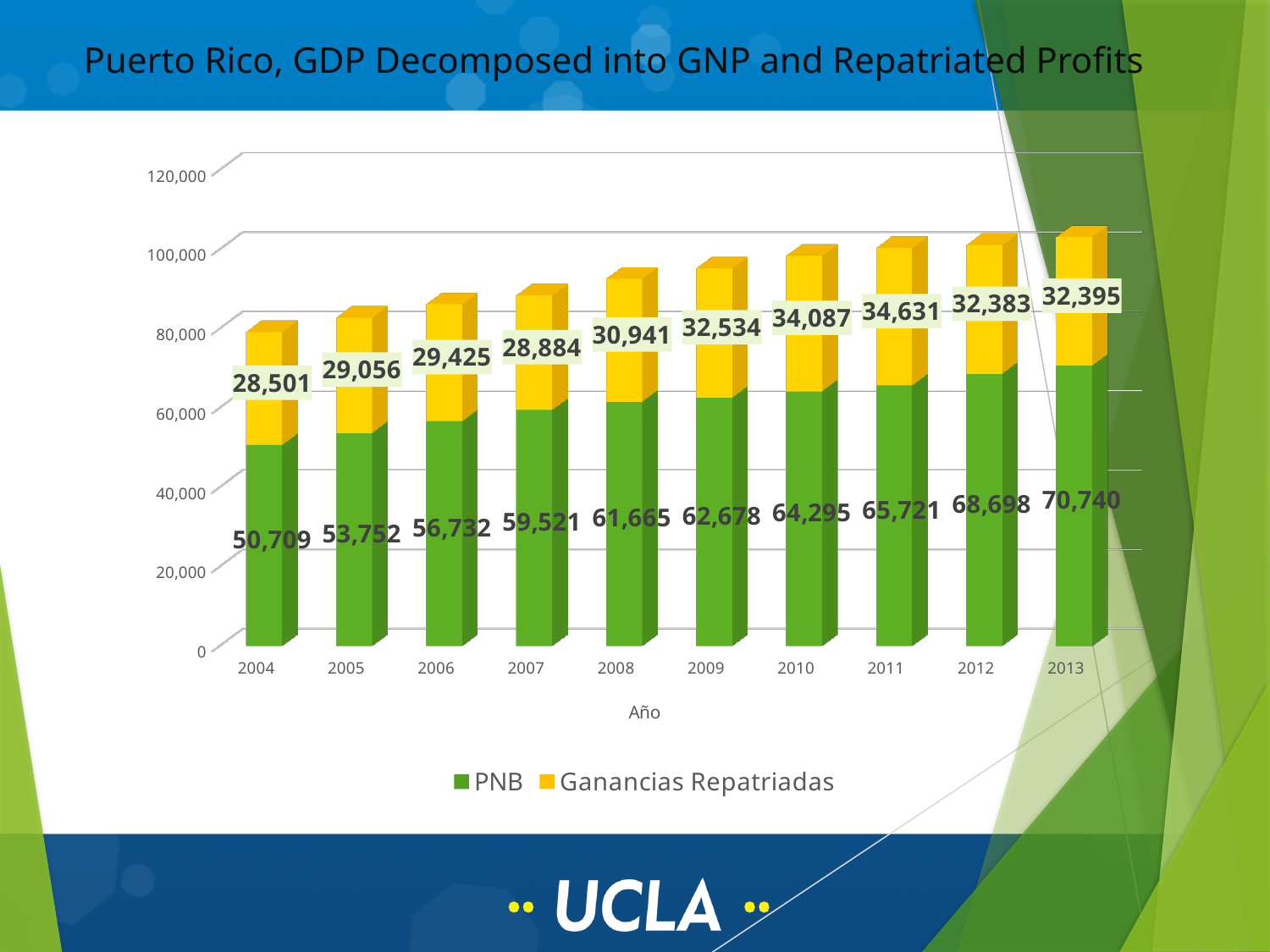
What is the PNB value for 2008? 61,665 Which is larger, the Ganancias Repatriadas value in 2009 or in 2007? 2009 What type of chart is shown on the slide? Stacked bar chart Does the PNB value rise or fall from 2004 to 2013? Rise How many years are shown on the x axis? 10 What is the label on the x axis? Año Which year has the lowest PNB value? 2004 What is the Ganancias Repatriadas value for 2010? 34,087 Which year has the highest Ganancias Repatriadas value? 2011 How many series does the legend list? 2 What is the difference between the PNB value in 2013 and in 2004? 20,031 What is the total of the stacked bar for 2004? 79,210